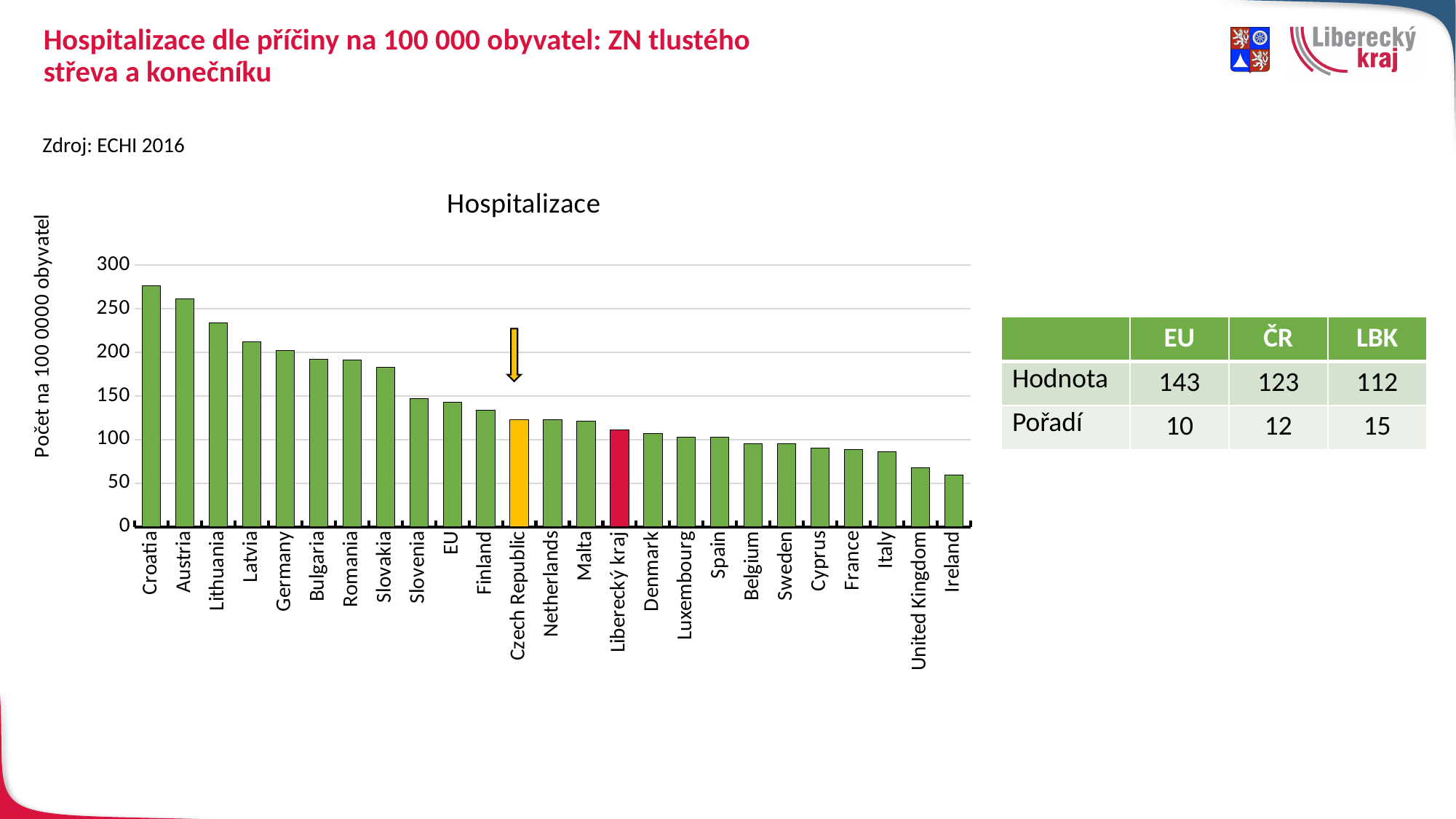
What is the hospitalization value for Liberecký kraj (LBK) according to the slide? 112 Which country has the lowest hospitalization rate in the chart? Ireland Is the value for Italy greater or less than 100? less How many categories (bars) are shown in the chart? 25 Is the value for Croatia greater or less than 250? greater What is the difference between the EU value and the Liberecký kraj (LBK) value? 31 What is the hospitalization value for the EU according to the slide? 143 What is the title of the chart? Hospitalizace Do the values rise or fall from left to right along the x axis? fall What is the hospitalization value for the Czech Republic (ČR) according to the slide? 123 Which country has the highest hospitalization rate in the chart? Croatia What type of chart is shown on the slide? bar chart